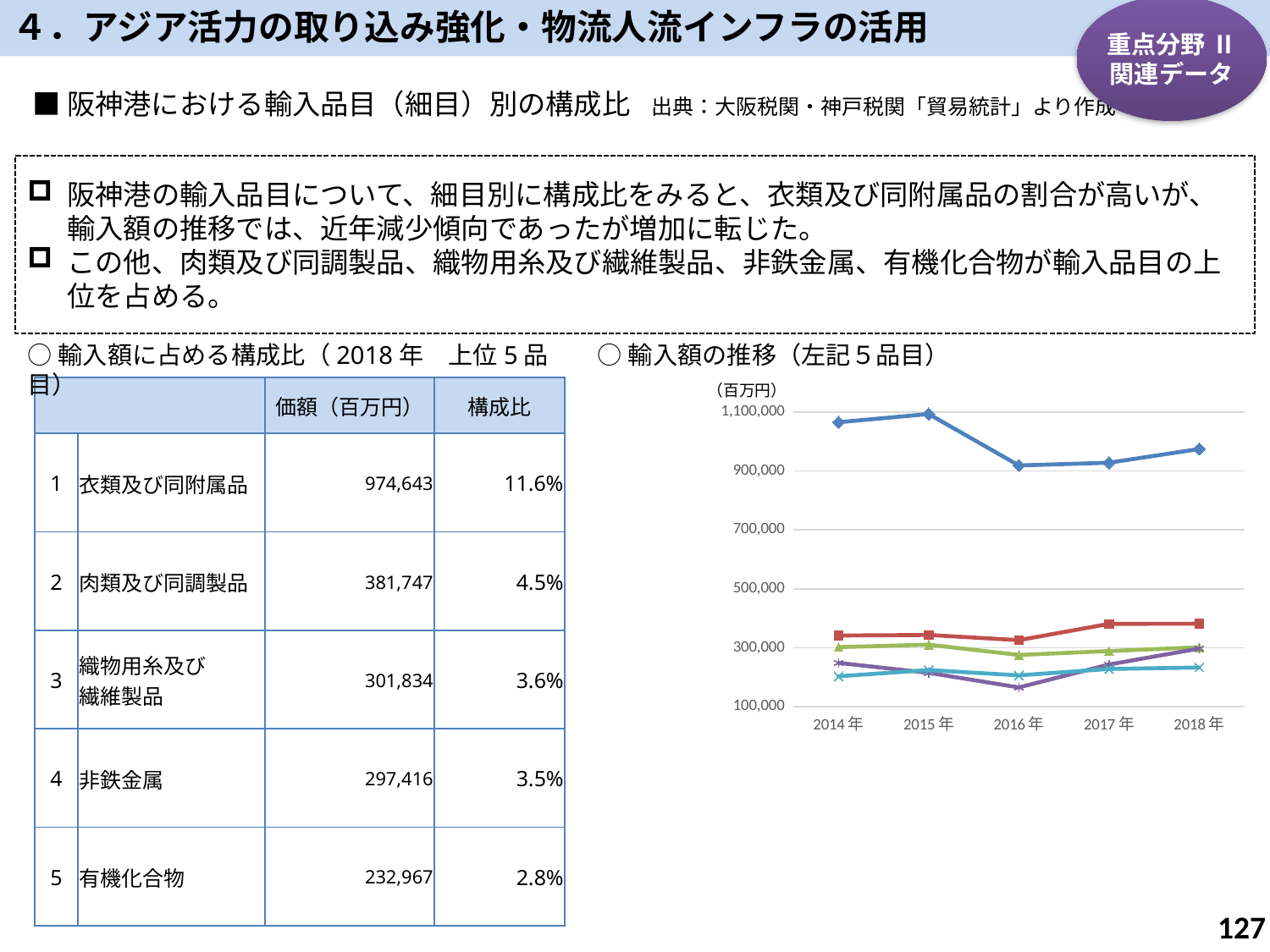
In the 輸入額の推移 chart, is the value of the purple line in 2016年 greater or less than 300,000? less In the 輸入額の推移 chart, how many lines are plotted? 5 In the 輸入額の推移 chart, does the blue line rise or fall from 2016年 to 2018年? rise In the 輸入額の推移 chart, is the value of the blue line in 2014年 greater or less than 900,000? greater In the 輸入額の推移 chart, which is larger in 2018年, the blue line or the red line? the blue line In the 輸入額の推移 chart, what unit is shown at the top of the y axis? （百万円） In the 輸入額の推移 chart, is the value of the light blue line in 2014年 greater or less than 100,000? greater In the 輸入額の推移 chart, how many years are plotted along the x axis? 5 In the 輸入額の推移 chart, does the blue line rise or fall from 2015年 to 2016年? fall What kind of chart is shown under 輸入額の推移（左記５品目）? line chart